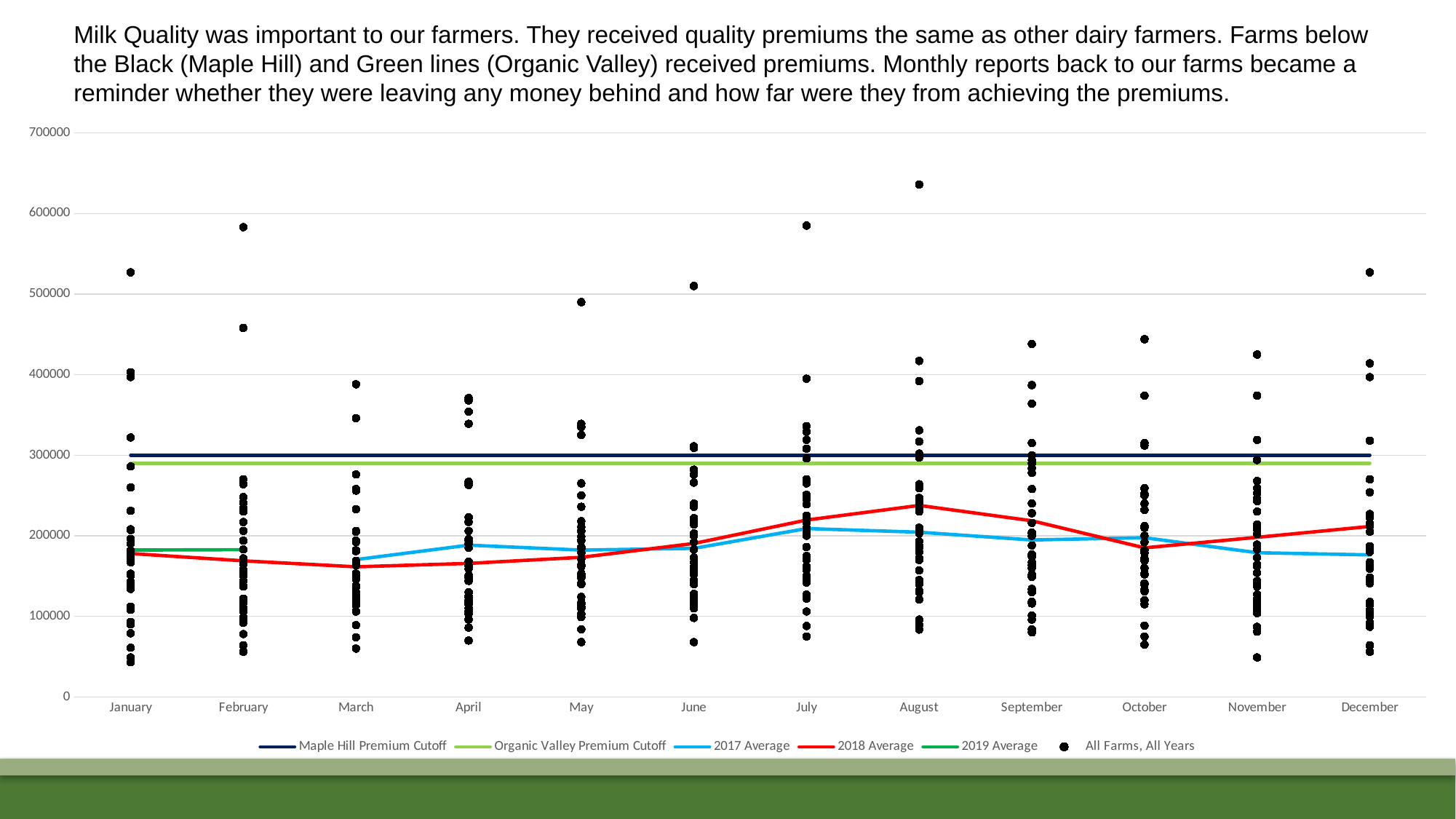
How many series does the chart legend list? 6 How many months are shown on the x axis of the chart? 12 Is the 2018 Average value for August greater or less than 200000? greater In which month does the 2018 Average reach its highest value? August Does the 2018 Average rise or fall from March to August? rise Which series is drawn as a red line? 2018 Average What kind of chart is shown on the slide? line chart Is the Organic Valley Premium Cutoff line greater or less than 300000? less Is the 2018 Average value for March greater or less than 200000? less In October, which is higher: the 2017 Average or the 2018 Average? 2017 Average What value does the Maple Hill Premium Cutoff line sit at? 300000 In August, which is higher: the 2017 Average or the 2018 Average? 2018 Average